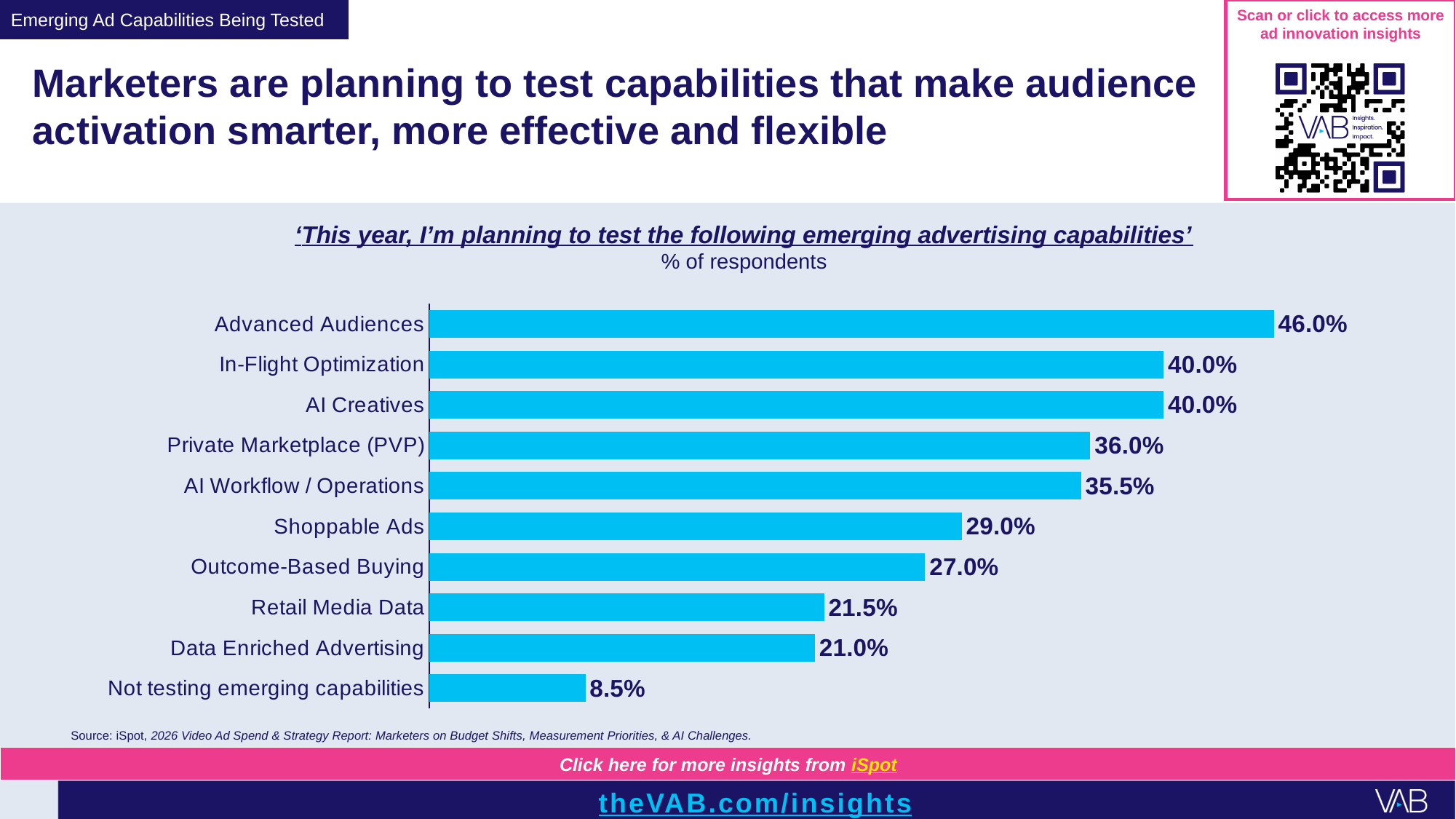
Which is larger, the value for Private Marketplace (PVP) or the value for Outcome-Based Buying? Private Marketplace (PVP) How many categories are shown on the chart? 10 What percentage of respondents are planning to test Advanced Audiences? 46.0% What is the value shown for Shoppable Ads? 29.0% What is the subtitle under the chart title indicating the unit of measurement? % of respondents Which two capabilities share the same value of 40.0%? In-Flight Optimization and AI Creatives Which category has the lowest value on the chart? Not testing emerging capabilities What percentage of respondents are not testing emerging capabilities? 8.5% What kind of chart is shown on the slide? Bar chart What is the difference between the values for Advanced Audiences and In-Flight Optimization? 6.0% Which capability has the highest percentage of respondents planning to test it? Advanced Audiences What is the difference between Retail Media Data and Data Enriched Advertising? 0.5%